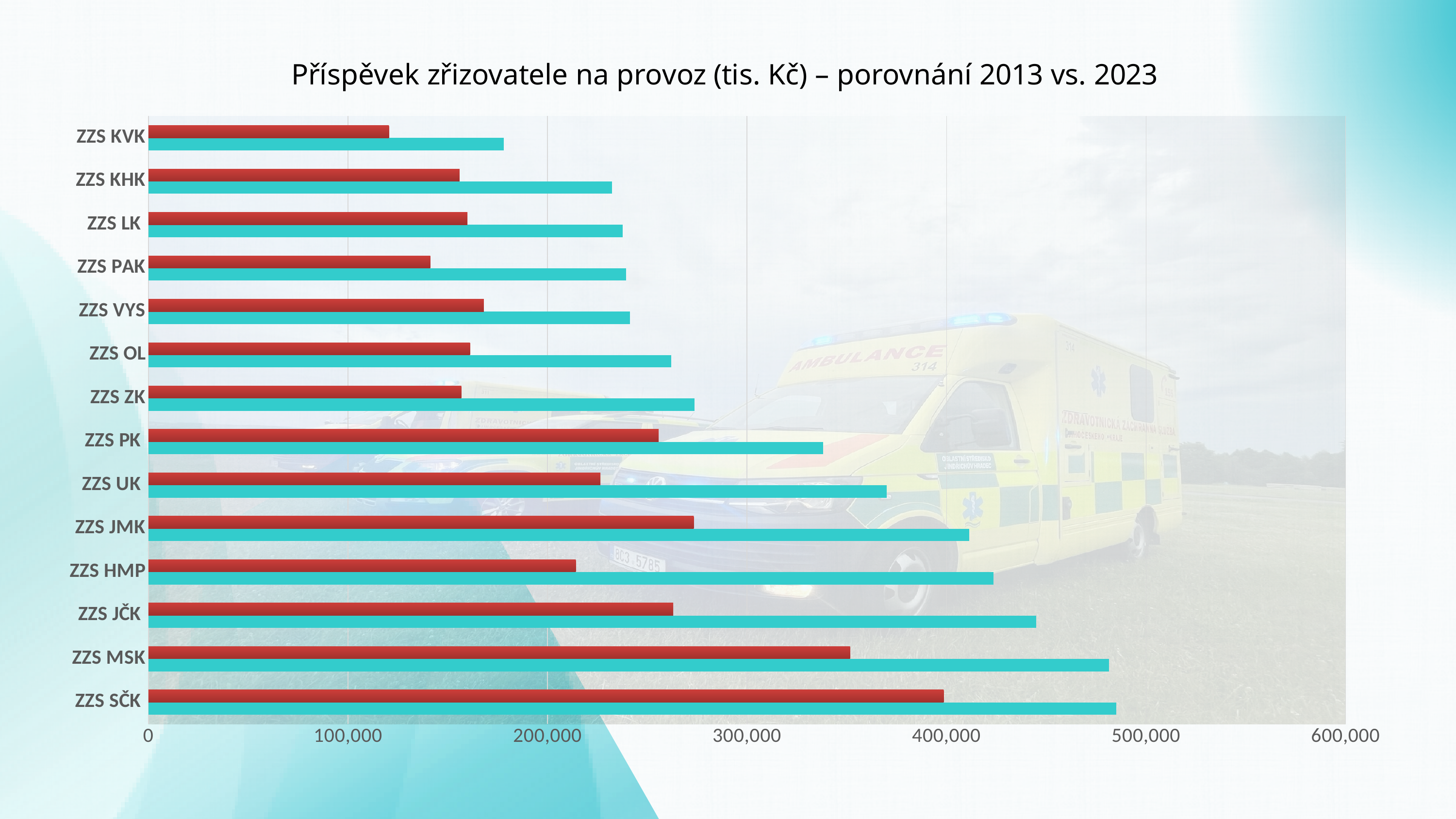
What is the title of the chart? Příspěvek zřizovatele na provoz (tis. Kč) – porovnání 2013 vs. 2023 Which category has the shortest red bar? ZZS KVK Is the red bar for ZZS MSK greater or less than 300,000? greater Is the teal bar for ZZS SČK greater or less than 500,000? less Which category has the longest red bar? ZZS SČK Is the teal bar for ZZS HMP greater or less than 400,000? greater What kind of chart is shown on the slide? bar chart Which category has the shortest teal bar? ZZS KVK Which is larger, the teal bar for ZZS PK or the teal bar for ZZS UK? ZZS UK How many categories (ZZS organisations) are shown on the chart? 14